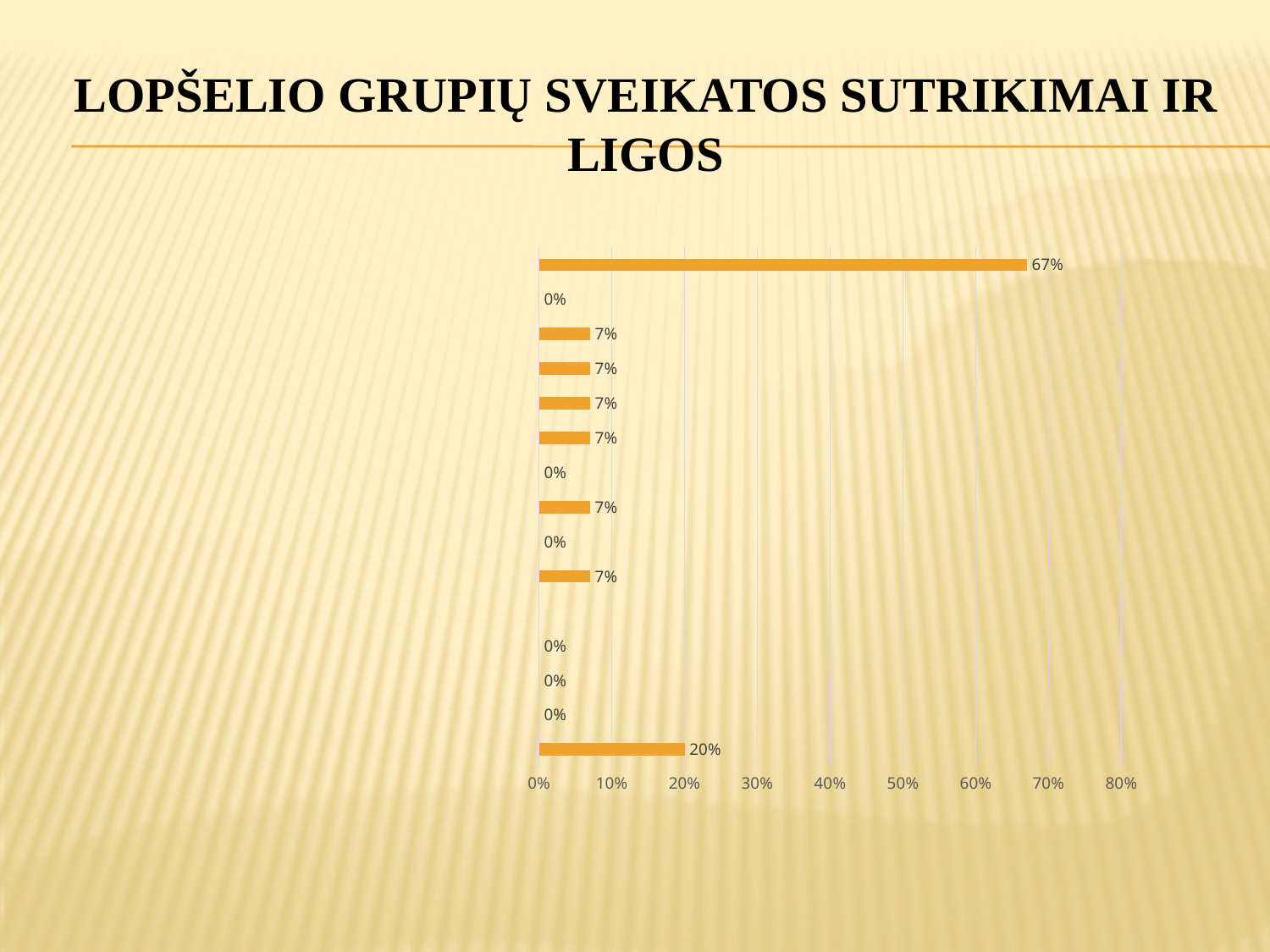
Which is larger, the topmost bar or the bottom bar? the topmost bar What colour are the bars in the chart? orange Is the value of the longest bar greater or less than 60%? greater What is the difference between the topmost bar (67%) and the bottom bar (20%)? 47% What is the highest tick value shown on the horizontal axis? 80% How many bars in the chart are labelled 7%? 6 Is the value of the bottom bar greater or less than 30%? less What kind of chart is shown on the slide? bar chart What is the highest value shown in the chart? 67% What is the value of the bottom bar in the chart? 20% What is the value of the topmost bar in the chart? 67% What is the second-highest value shown in the chart? 20%